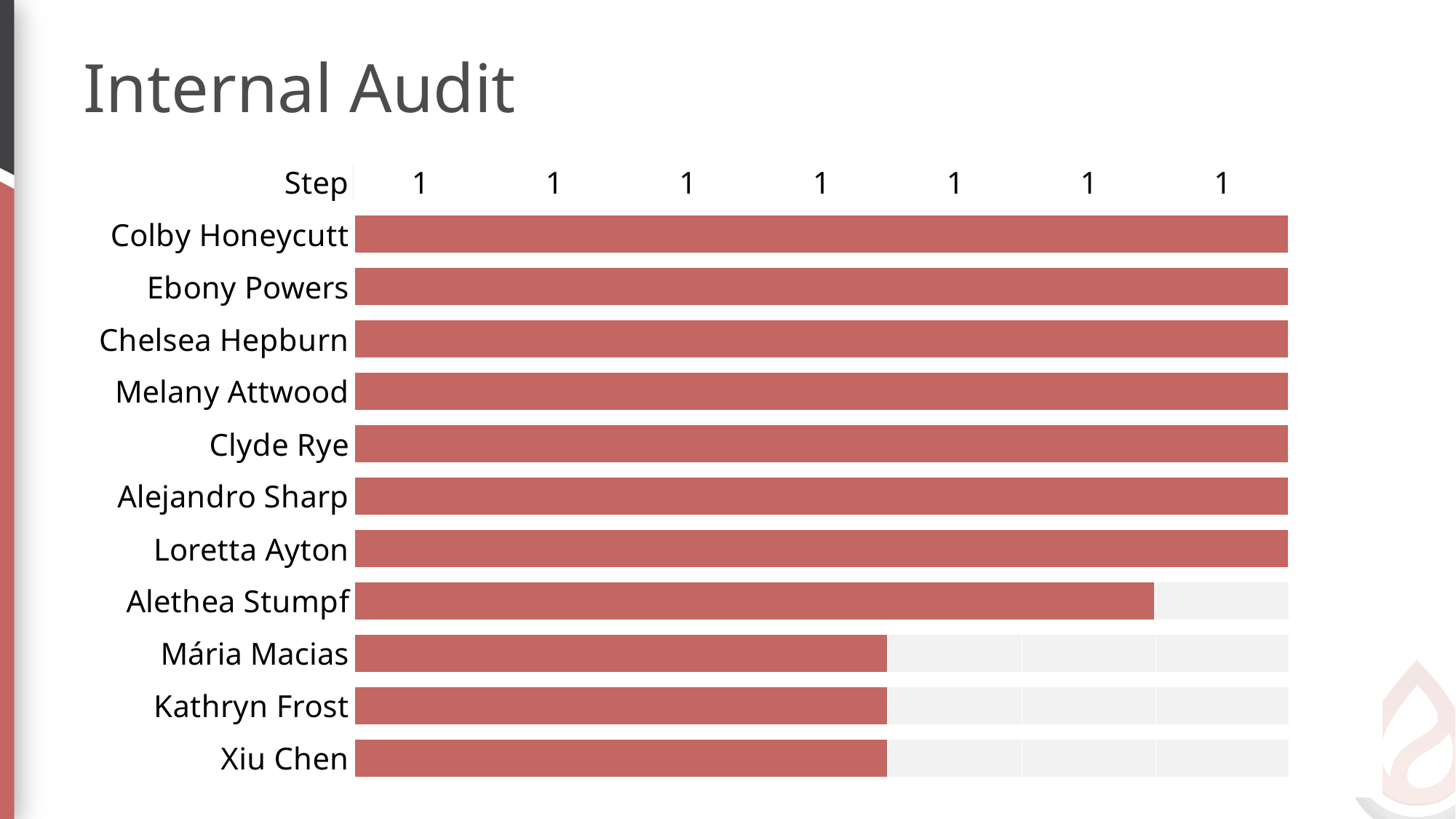
What kind of chart is shown on the slide? bar chart Which bar is longer, Loretta Ayton's or Alethea Stumpf's? Loretta Ayton How many people are listed as categories in the chart? 11 Which person is listed first (at the top) in the chart? Colby Honeycutt Which bar is longer, Colby Honeycutt's or Xiu Chen's? Colby Honeycutt What label appears at the top of the category column in the chart? Step Which bar is longer, Kathryn Frost's or Clyde Rye's? Clyde Rye How many step columns are shown across the top of the chart? 7 What is the title of the slide containing the chart? Internal Audit